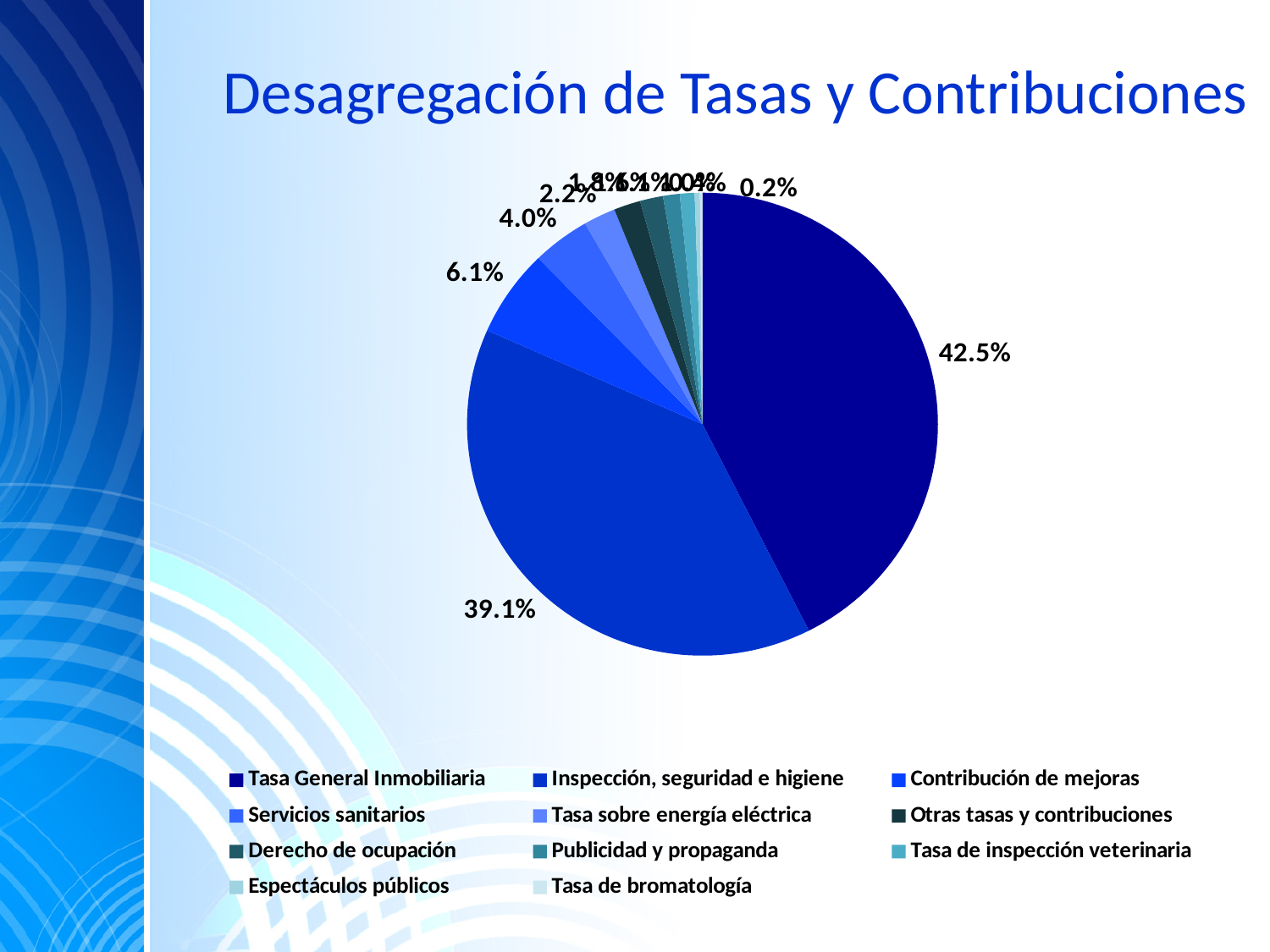
What share of the pie does Inspección, seguridad e higiene represent? 39.1% What kind of chart is shown on the slide? Pie chart What share of the pie does Servicios sanitarios represent? 4.0% Which is larger, the slice for Contribución de mejoras or the slice for Servicios sanitarios? Contribución de mejoras What share of the pie does Tasa General Inmobiliaria represent? 42.5% Which category has the largest slice of the pie? Tasa General Inmobiliaria What is the title of the chart? Desagregación de Tasas y Contribuciones What share of the pie does Contribución de mejoras represent? 6.1% What is the difference in percentage points between Tasa General Inmobiliaria and Inspección, seguridad e higiene? 3.4 percentage points What share of the pie does Tasa sobre energía eléctrica represent? 2.2% How many categories does the legend list? 11 What is the combined share of Tasa General Inmobiliaria and Inspección, seguridad e higiene? 81.6%